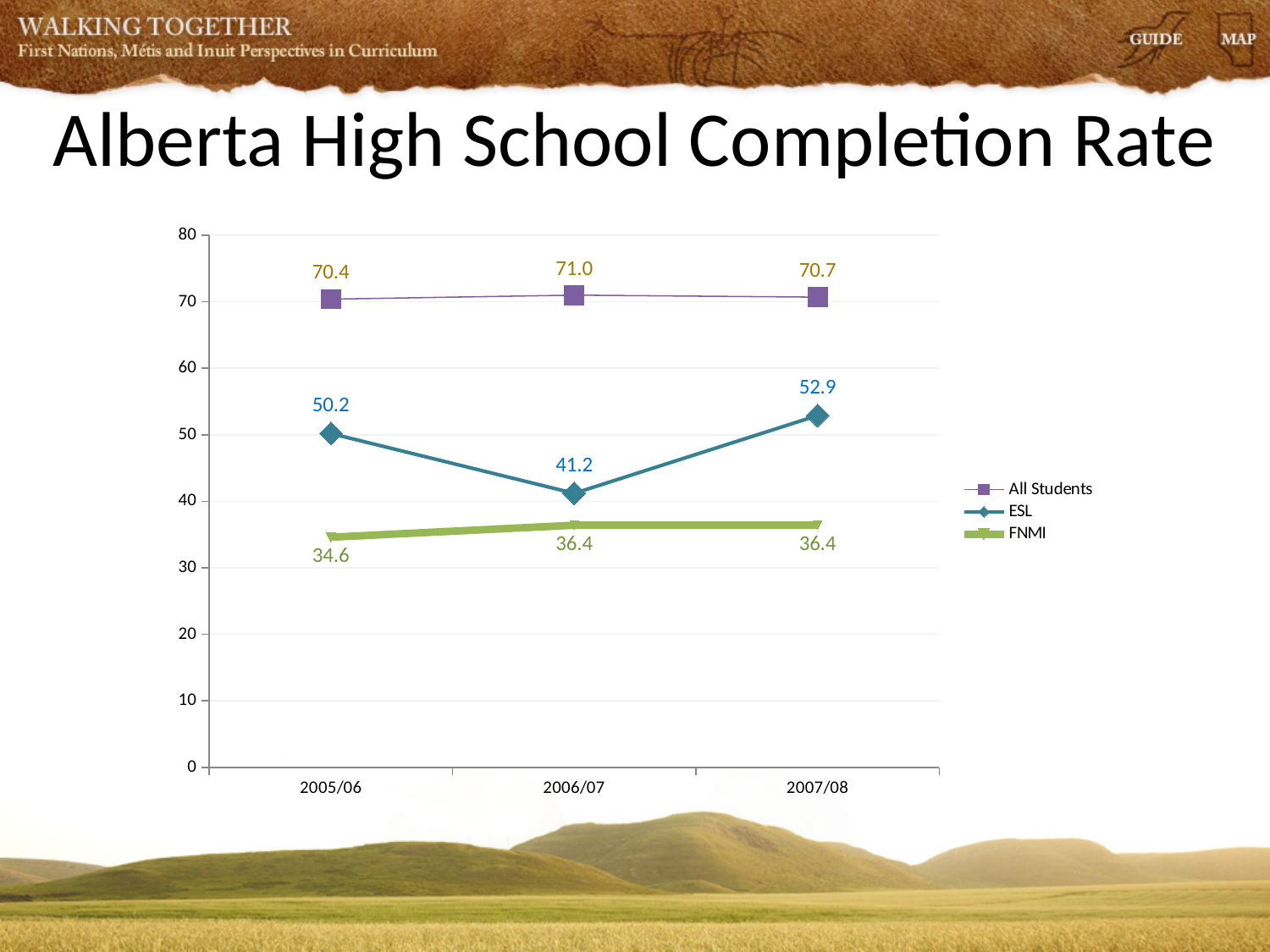
How many series does the legend list? 3 What is the completion rate for ESL students in 2005/06? 50.2 What is the completion rate for All Students in 2006/07? 71.0 How many school years are shown on the x axis? 3 What is the difference between the ESL rate in 2007/08 and in 2006/07? 11.7 In which year was the ESL completion rate highest? 2007/08 What kind of chart is shown on the slide? line chart Which was higher in 2006/07, the ESL rate or the FNMI rate? ESL Is the FNMI completion rate in 2005/06 greater or less than 40? less What is the completion rate for FNMI students in 2007/08? 36.4 What is the difference between the All Students rate and the FNMI rate in 2005/06? 35.8 In which year was the ESL completion rate lowest? 2006/07